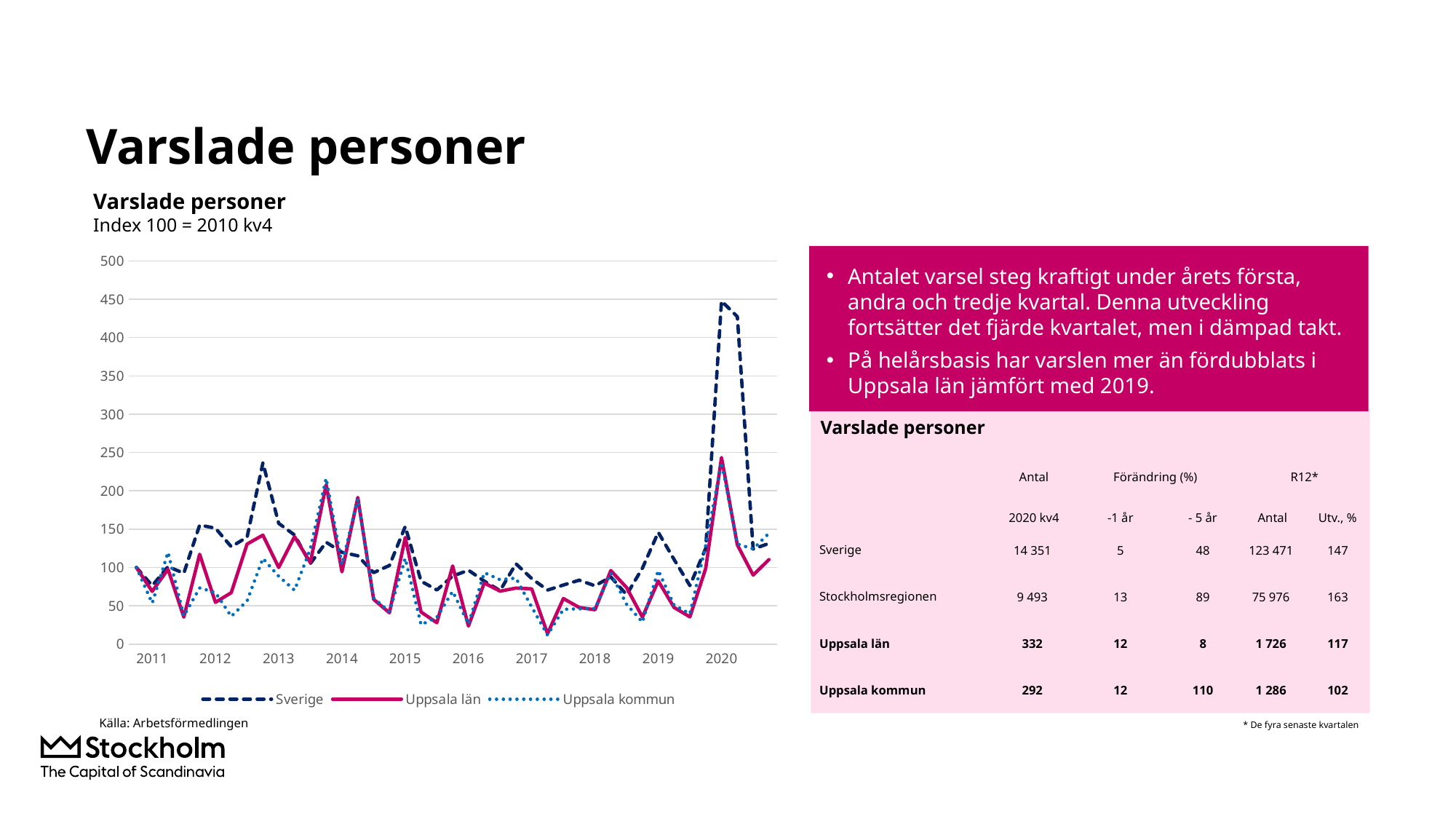
How many series does the chart legend list? 3 Is the peak value for Sverige in 2020 greater or less than 400? greater What is the index base stated under the chart title? Index 100 = 2010 kv4 What is the highest value shown on the y axis? 500 Is the peak value for Uppsala län in 2020 greater or less than 200? greater Is the lowest value for Uppsala kommun in 2017 greater or less than 50? less Does the Sverige series rise or fall sharply at the start of 2020? rise At the 2020 peak, which is larger: Sverige or Uppsala län? Sverige Which series reaches the highest peak in 2020? Sverige What is the first year shown on the x axis? 2011 What kind of chart is shown on the slide? line chart